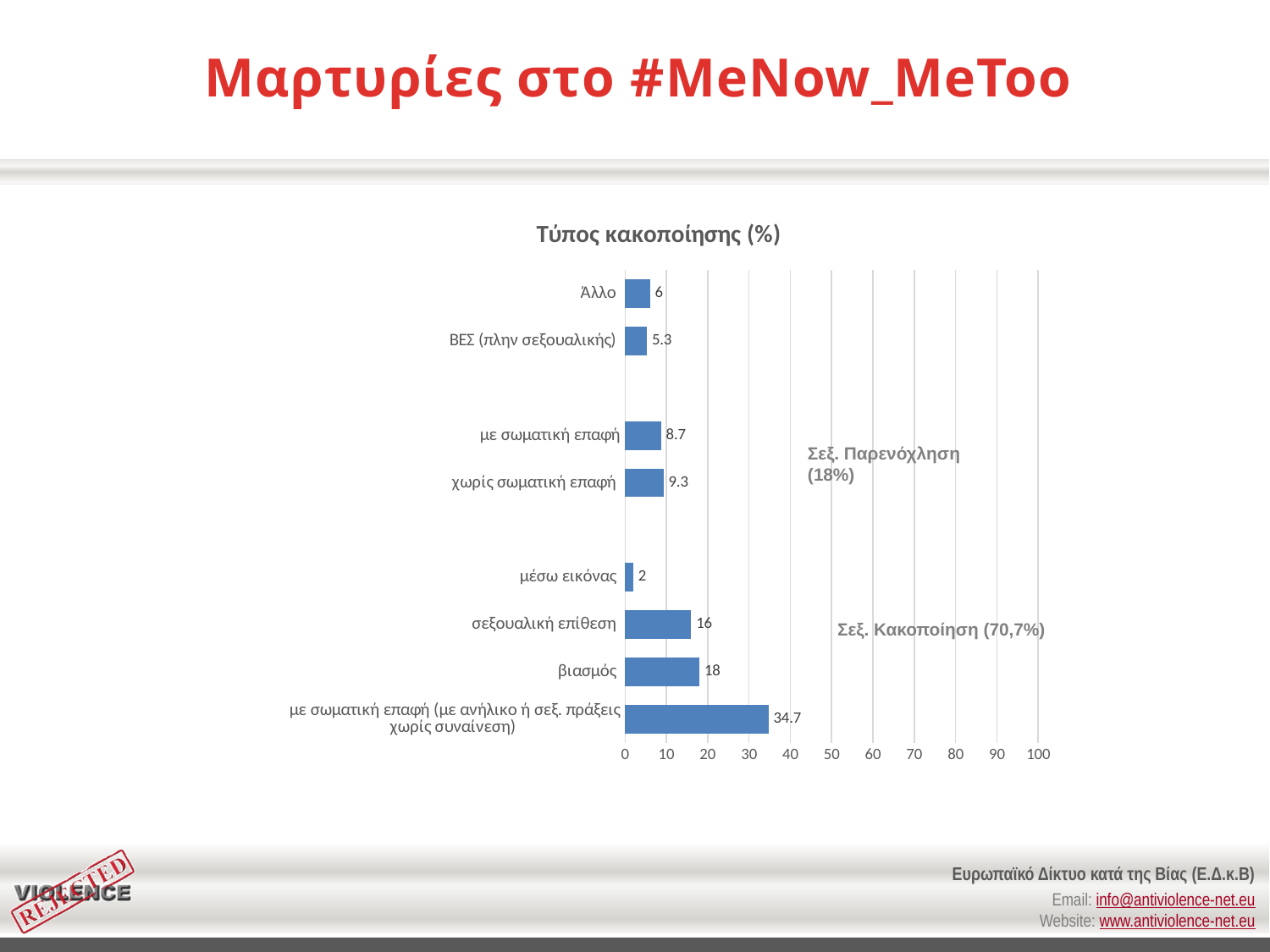
What type of chart is shown on the slide? bar chart Which category has the highest value? με σωματική επαφή (με ανήλικο ή σεξ. πράξεις χωρίς συναίνεση) What is the difference between the values for βιασμός and σεξουαλική επίθεση? 2 Which is larger, the value for Άλλο or the value for ΒΕΣ (πλην σεξουαλικής)? Άλλο What is the value for χωρίς σωματική επαφή? 9.3 How many bars (categories) does the chart show? 8 What is the title of the chart? Τύπος κακοποίησης (%) What is the value for σεξουαλική επίθεση? 16 What is the value for βιασμός? 18 What is the value for ΒΕΣ (πλην σεξουαλικής)? 5.3 Which category has the lowest value? μέσω εικόνας What percentage is given for Σεξ. Κακοποίηση in the annotation on the chart? 70,7%